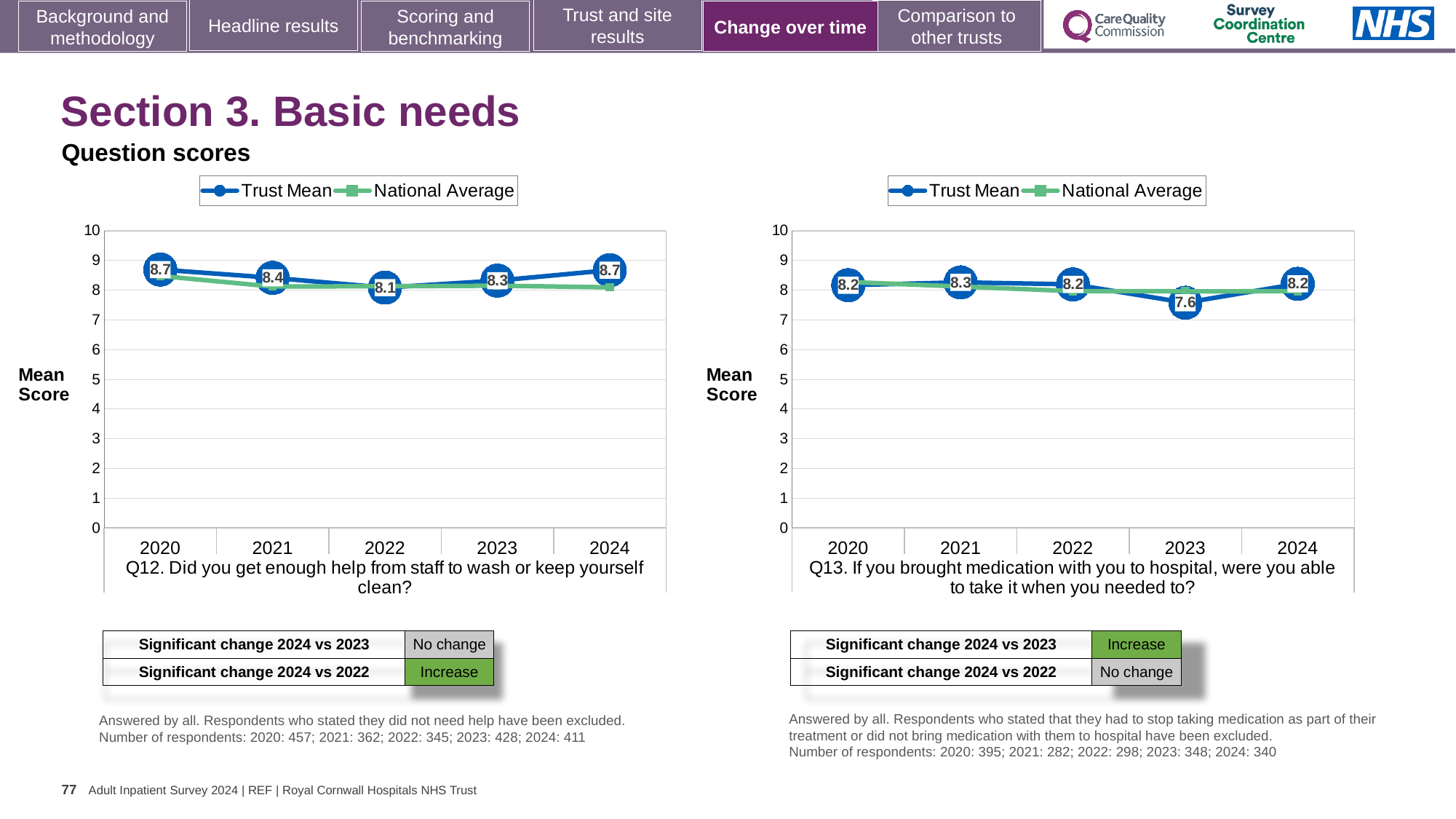
In the Q12 chart (left), what is the difference between the Trust Mean for 2024 and 2022? 0.6 How many series does the legend of the Q12 chart (left) list? 2 In the Q13 chart (right), what is the Trust Mean for 2023? 7.6 What type of chart is the Q13 chart (right)? Line chart In the Q13 chart (right), which is larger, the Trust Mean for 2021 or for 2023? 2021 In the Q12 chart (left), which year has the lowest Trust Mean? 2022 In the Q12 chart (left), how many years are plotted on the x axis? 5 In the Q12 chart (left), what is the Trust Mean for 2024? 8.7 In the Q12 chart (left), what is the Trust Mean for 2022? 8.1 In the Q13 chart (right), is the Trust Mean for 2023 greater or less than 8? less In the Q13 chart (right), which year has the lowest Trust Mean? 2023 In the Q13 chart (right), which year has the highest Trust Mean? 2021